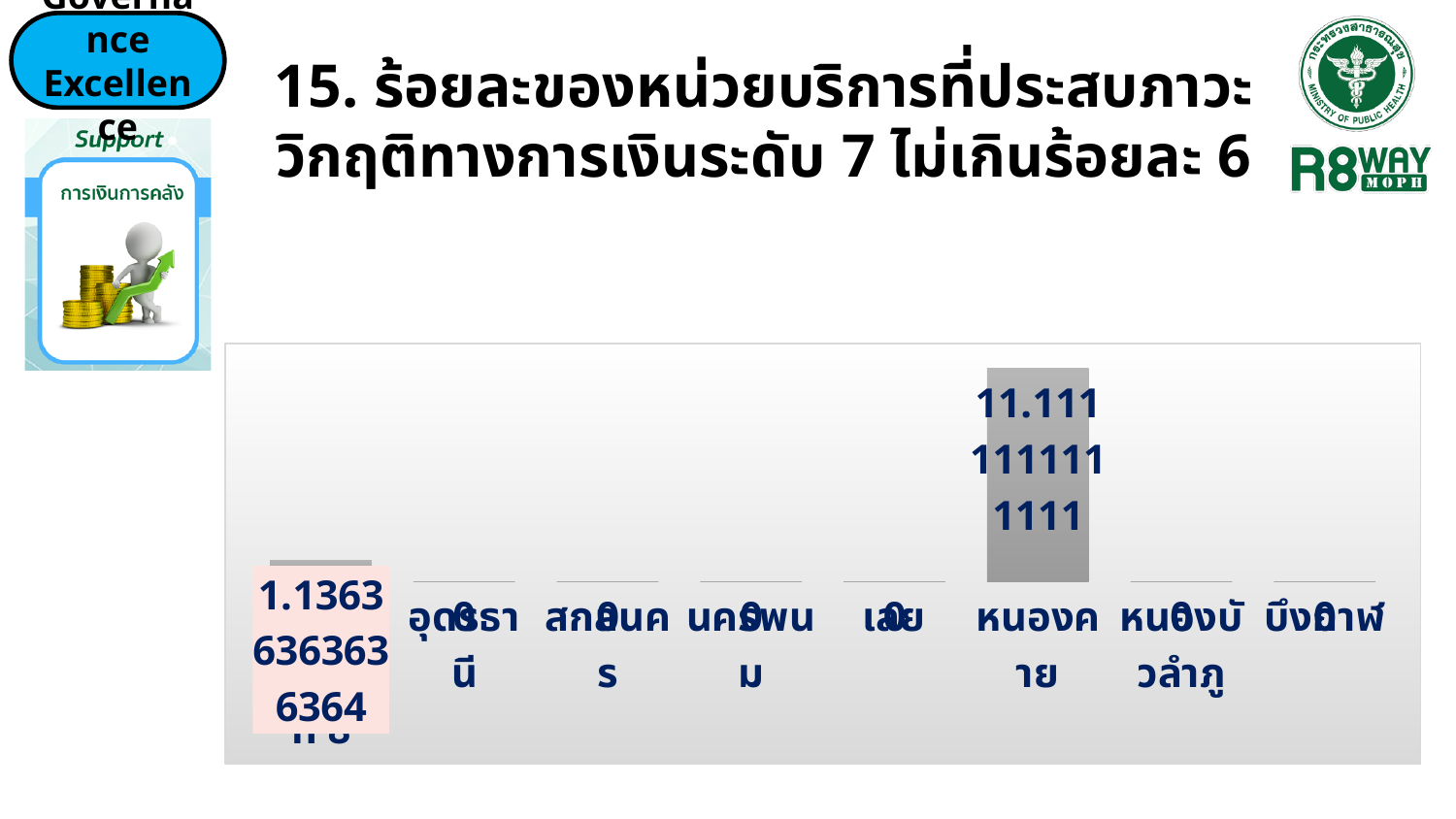
Which is larger, the value for หนองคาย or the value for นครพนม? หนองคาย What is the value shown for บึงกาฬ? 0 What is the value shown for อุดรธานี? 0 What is the value shown for เลย? 0 How many categories are plotted along the x axis of the chart? 8 Which category has the highest value in the chart? หนองคาย What indicator number is given in the slide title above the chart? 15 What is the value shown for สกลนคร? 0 What colour is the bar for หนองคาย? grey Which is larger, the value for หนองคาย or the value for อุดรธานี? หนองคาย What is the value shown for หนองบัวลำภู? 0 What kind of chart is shown on the slide? bar chart